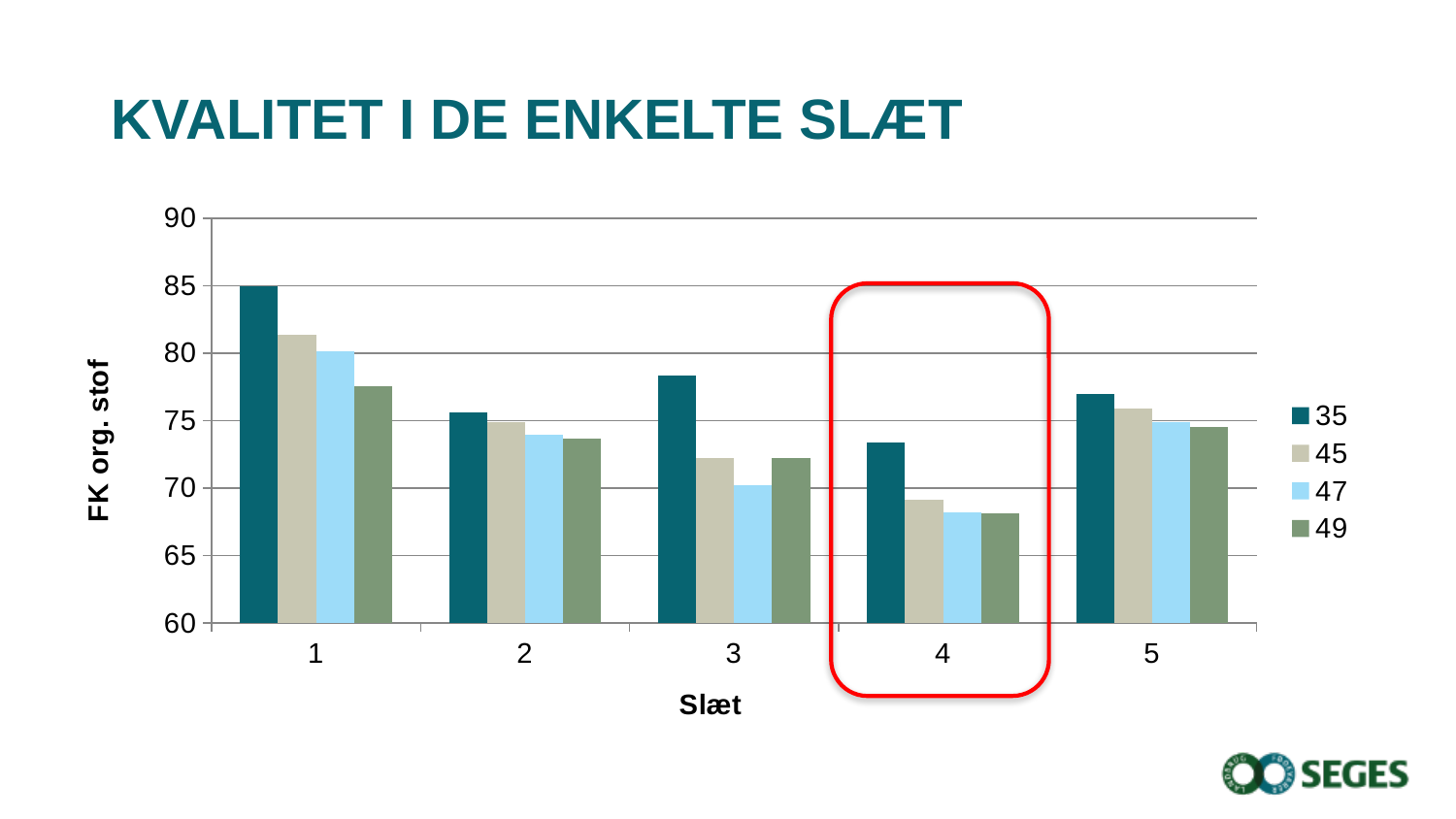
How many series does the legend list? 4 What kind of chart is shown on the slide? bar chart How many Slæt categories are shown on the x axis? 5 For series 35, which Slæt has the lowest value? 4 What is the title of the y axis? FK org. stof Is the value for series 45 at Slæt 4 greater or less than 70? less For series 35, which Slæt has the highest value? 1 Does the value for series 35 rise or fall from Slæt 1 to Slæt 2? fall Is the value for series 35 at Slæt 3 greater or less than 75? greater Which series has the highest value at Slæt 1? 35 Is the value for series 49 at Slæt 1 greater or less than 75? greater Which is larger for series 35: the value at Slæt 1 or at Slæt 3? Slæt 1